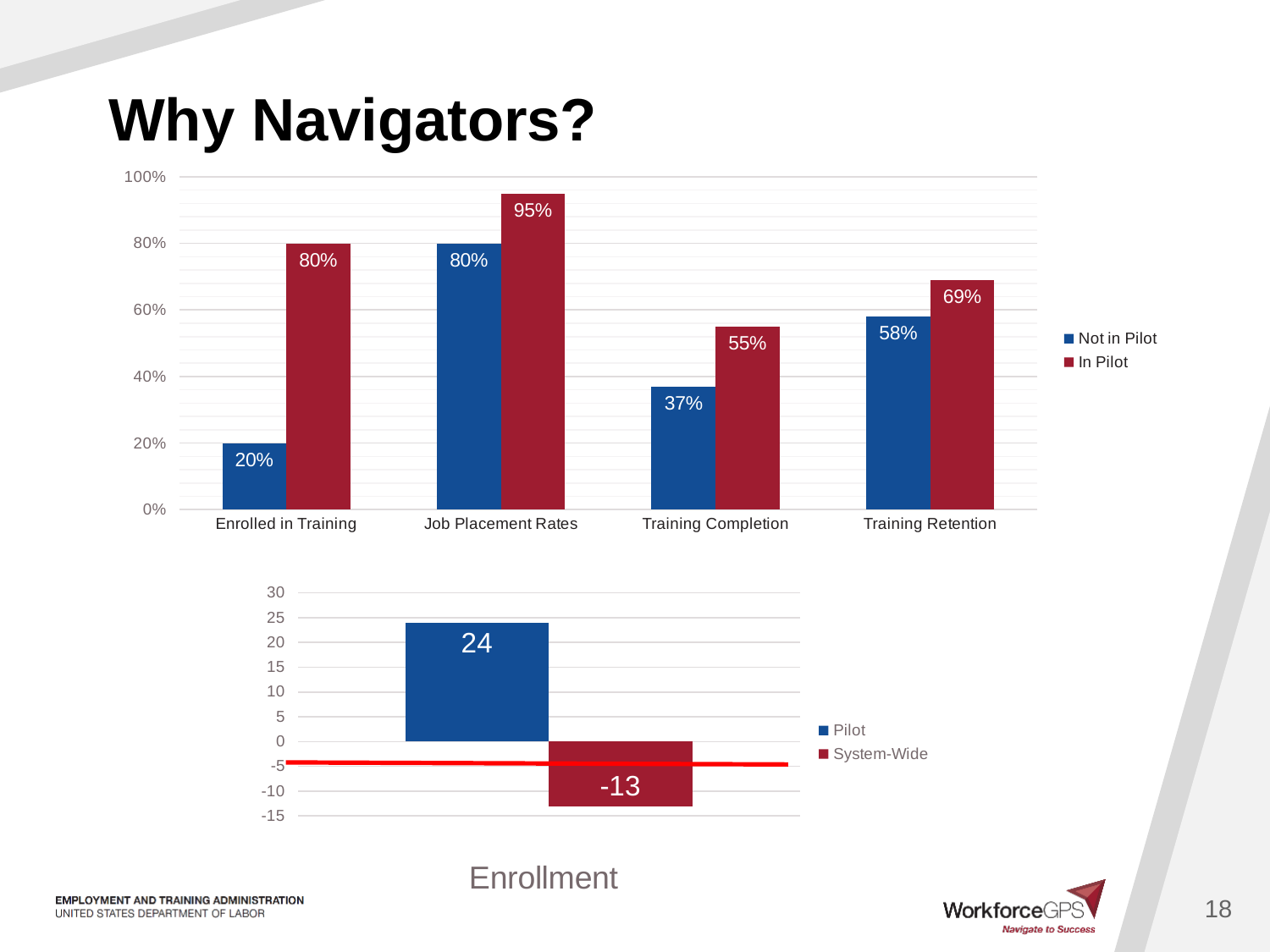
In the bottom chart, what is the value for Pilot? 24 In the top chart, what is the value for Not in Pilot for Enrolled in Training? 20% In the top chart, what is the value for In Pilot for Job Placement Rates? 95% In the bottom chart, what is the value for System-Wide? -13 In the top chart, what is the value for Not in Pilot for Training Completion? 37% In the top chart, what is the difference between the In Pilot and Not in Pilot values for Enrolled in Training? 60% How many series does the legend of the top chart list? 2 In the top chart, which is larger for Training Retention: In Pilot or Not in Pilot? In Pilot In the top chart, which category has the lowest Not in Pilot value? Enrolled in Training In the top chart, which category has the highest In Pilot value? Job Placement Rates What kind of chart is the bottom chart? Bar chart How many categories are shown on the x axis of the top chart? 4